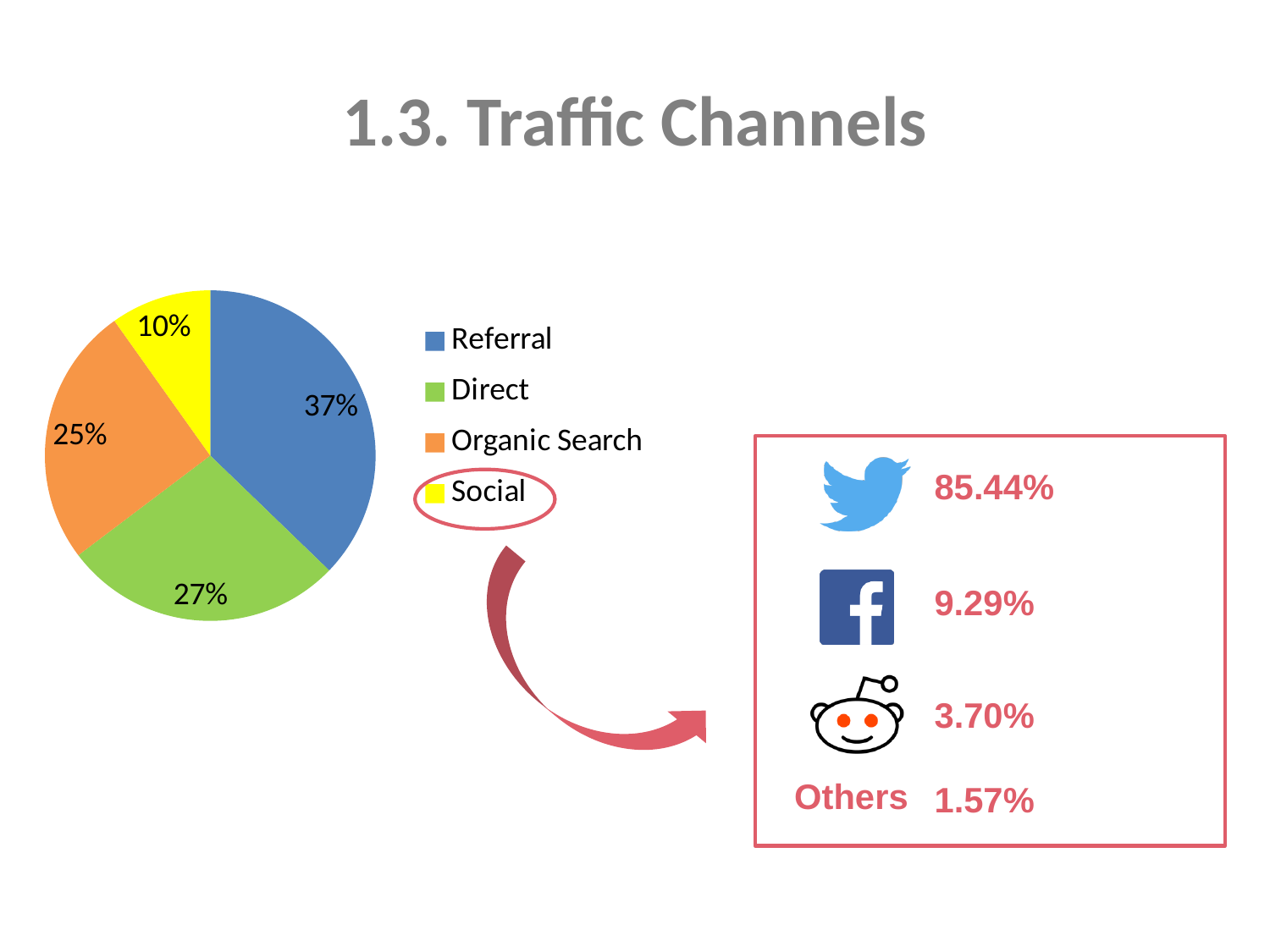
Which traffic channel has the largest share of the pie? Referral What share of traffic comes from Direct? 27% What share of traffic comes from Organic Search? 25% What is the difference in percentage points between Referral and Social? 27 What share of traffic comes from Referral? 37% Which traffic channel has the smallest share of the pie? Social What kind of chart is shown on the slide? Pie chart Which is larger, the Direct share or the Organic Search share? Direct How many entries does the legend list? 4 Which legend entry is circled in red on the slide? Social How many slices does the pie chart have? 4 What share of traffic comes from Social? 10%